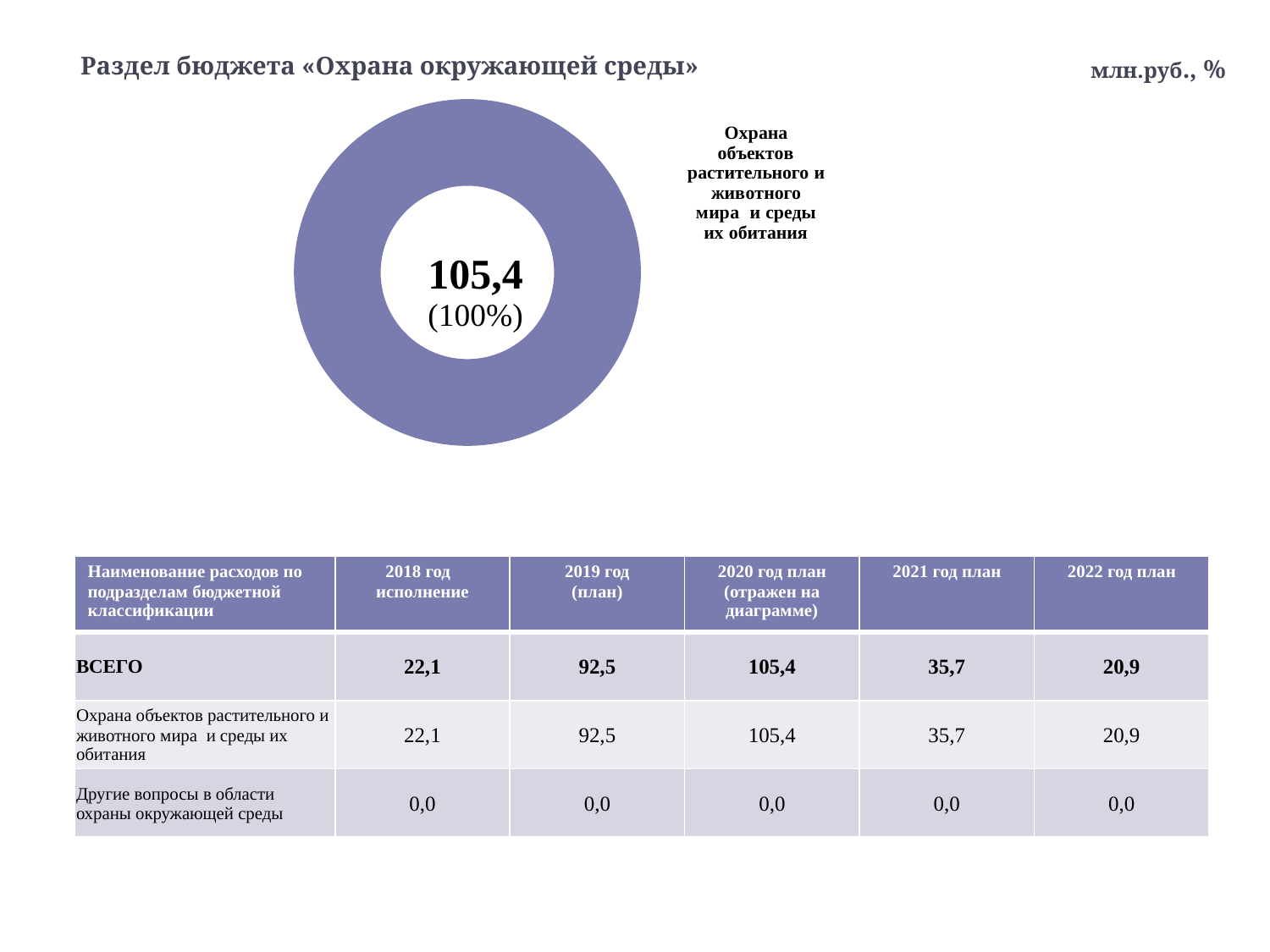
How many slices (categories) does the doughnut chart contain? 1 What is the title of the slide containing the doughnut chart? Раздел бюджета «Охрана окружающей среды» What total value is printed in the centre of the doughnut chart? 105,4 What kind of chart is shown on the slide? Pie (doughnut) chart What is the label of the only slice in the doughnut chart? Охрана объектов растительного и животного мира и среды их обитания What percentage is printed in parentheses in the centre of the doughnut chart? (100%) What share of the doughnut chart does the slice «Охрана объектов растительного и животного мира и среды их обитания» take? 100%